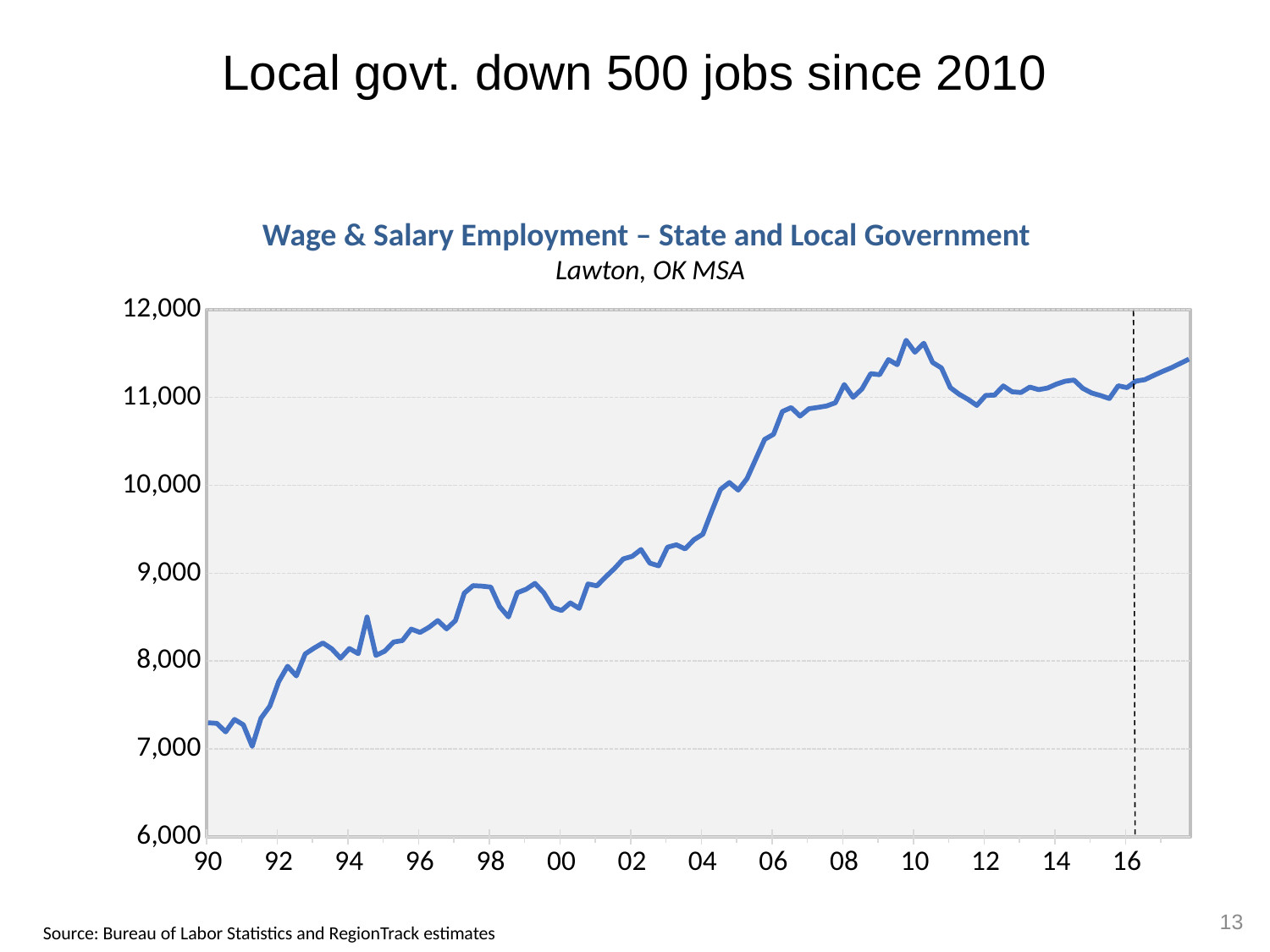
Is the value for 1990 greater or less than 8,000? less Is the value for 1996 greater or less than 8,000? greater Does the line rise or fall between 2010 and 2012? fall Around which year does the line reach its highest point? 2010 Which metropolitan area does the chart cover, according to its subtitle? Lawton, OK MSA What kind of chart is shown on the slide? line chart Is the value for 2006 greater or less than 10,000? greater Does the line generally rise or fall between 1990 and 2010? rise What is the title of the chart? Wage & Salary Employment – State and Local Government